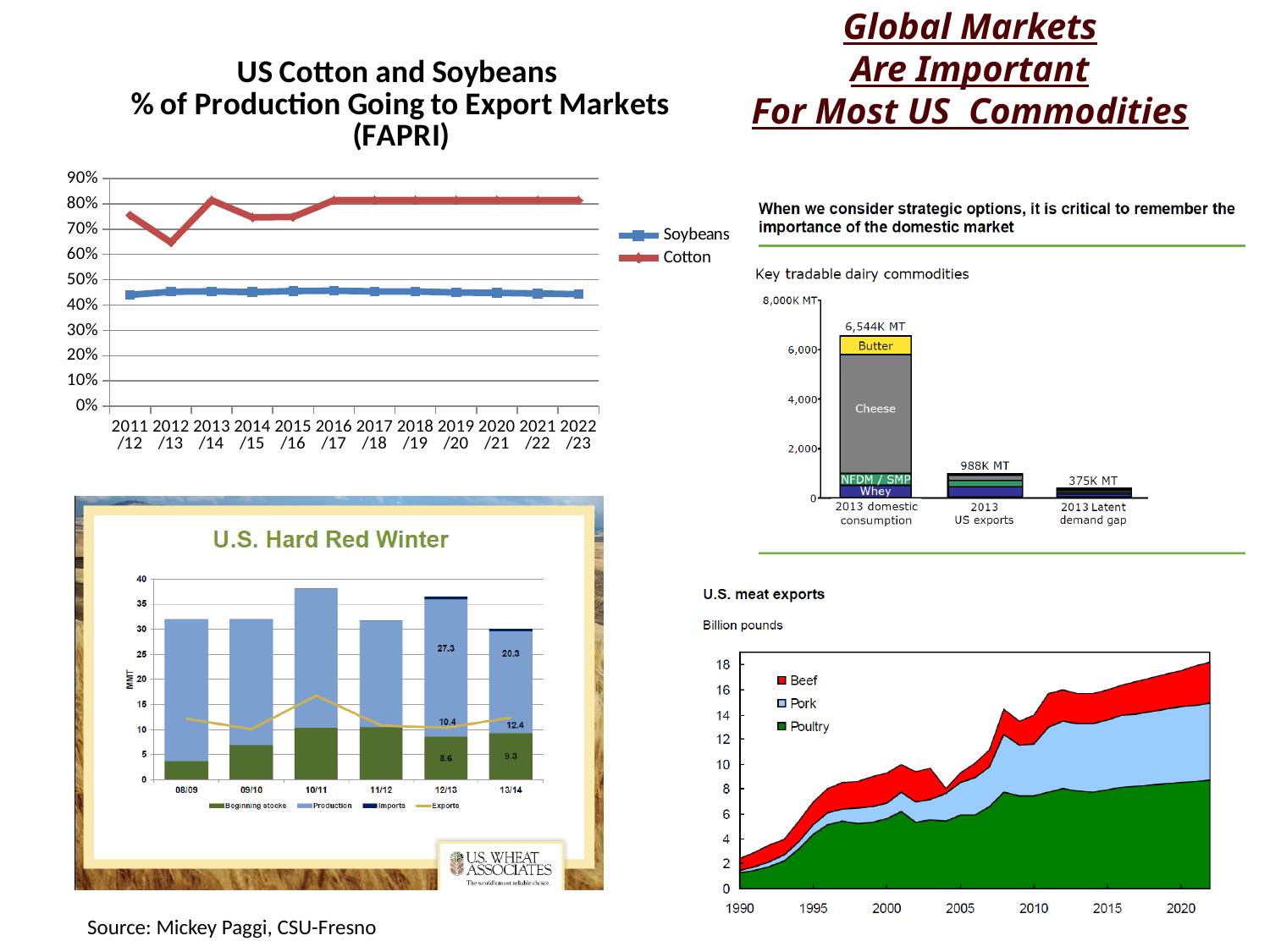
In the 'U.S. Hard Red Winter' chart, what is the Beginning stocks value for 13/14? 9.3 In the 'U.S. meat exports' chart, how many series does the legend list? 3 In the 'U.S. Hard Red Winter' chart, what is the Production value for 12/13? 27.3 In the 'US Cotton and Soybeans % of Production Going to Export Markets' chart, how many years are shown on the x axis? 12 In the 'Key tradable dairy commodities' chart, what is the total for 2013 US exports? 988K MT In the 'US Cotton and Soybeans % of Production Going to Export Markets' chart, which series has the higher value in 2015/16, Soybeans or Cotton? Cotton In the 'Key tradable dairy commodities' chart, what is the difference between the 2013 domestic consumption total and the 2013 Latent demand gap total? 6,169K MT In the 'US Cotton and Soybeans % of Production Going to Export Markets' chart, in which year is the Cotton value lowest? 2012/13 In the 'US Cotton and Soybeans % of Production Going to Export Markets' chart, how many series does the legend list? 2 In the 'US Cotton and Soybeans % of Production Going to Export Markets' chart, is the Cotton value for 2012/13 greater or less than 70%? less In the 'U.S. meat exports' chart, do total meat exports rise or fall from 1990 to 2020? rise